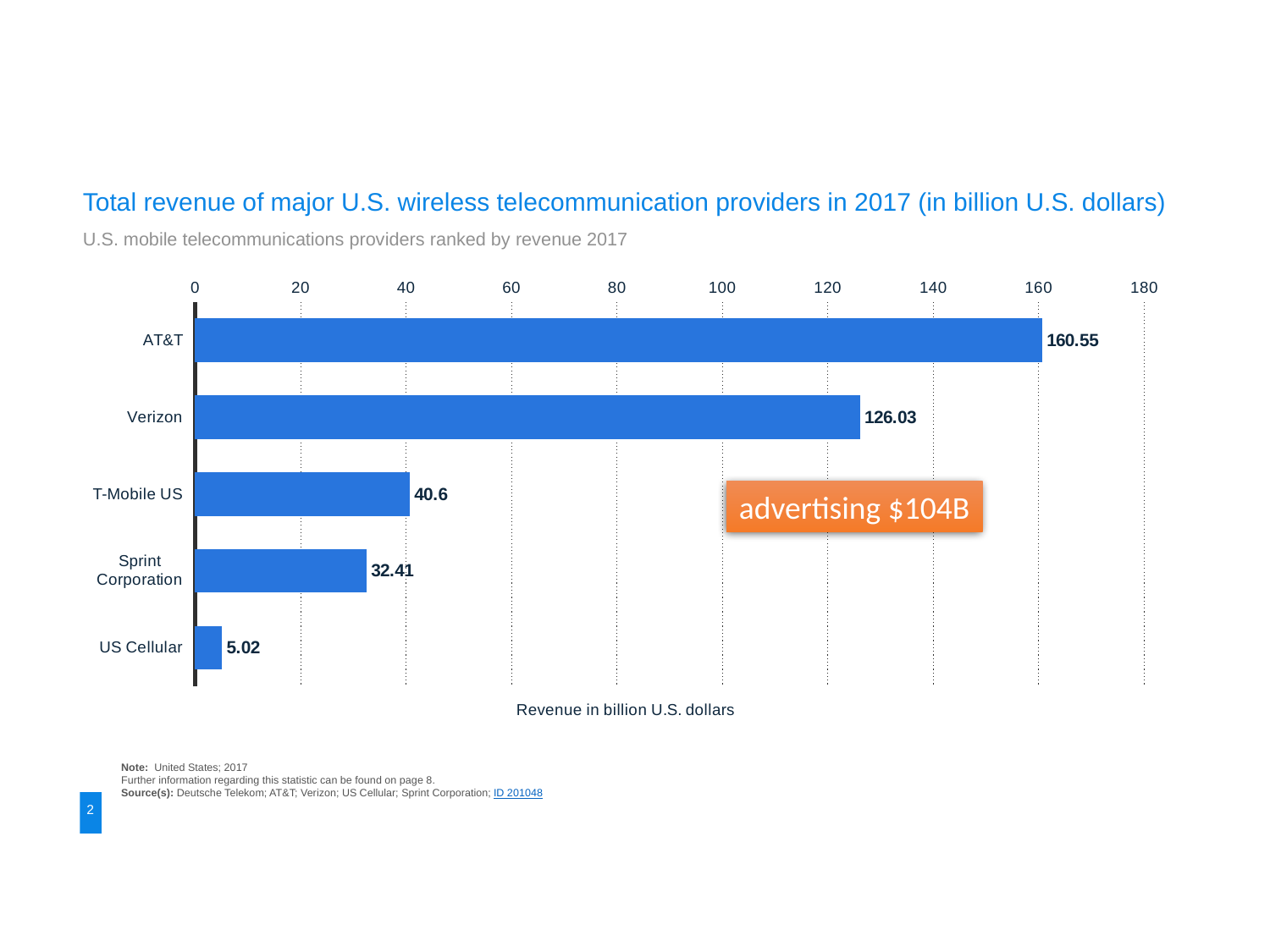
What is the difference between the revenue of AT&T and Verizon? 34.52 What kind of chart is shown on the slide? Bar chart What is the revenue value shown for Sprint Corporation? 32.41 Which provider has the highest revenue in the chart? AT&T What is the revenue value shown for Verizon? 126.03 Is the value for Verizon greater or less than 120? greater What is the label on the horizontal axis of the chart? Revenue in billion U.S. dollars How many providers are shown in the chart? 5 Which provider has the lowest revenue in the chart? US Cellular Which has a larger revenue, T-Mobile US or Sprint Corporation? T-Mobile US What is the revenue value shown for AT&T? 160.55 What is the revenue value shown for T-Mobile US? 40.6